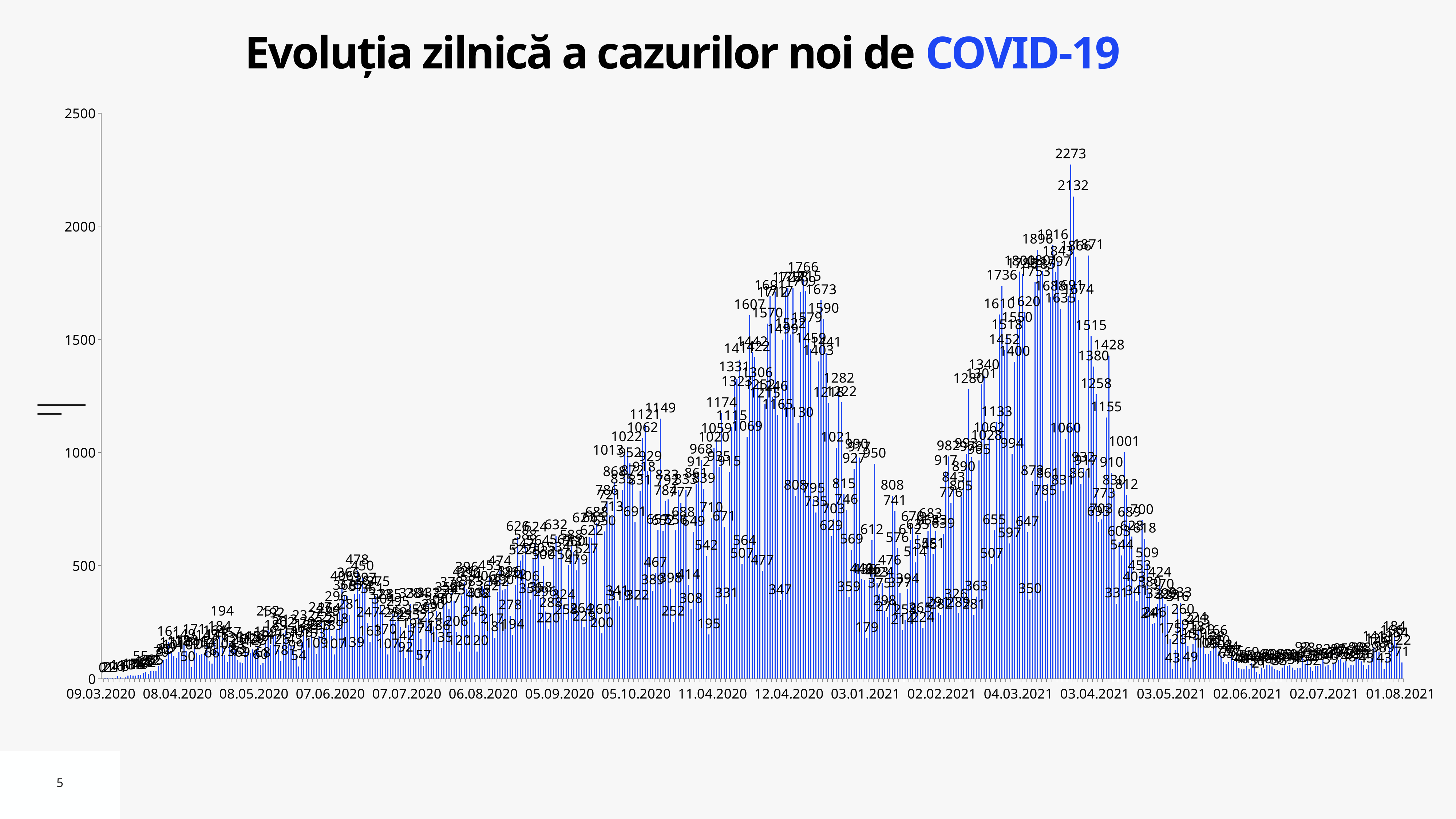
What is the last date shown on the x axis? 01.08.2021 What is the second-highest daily value labelled on the chart, just after the 2273 peak? 2132 Are the values around 02.06.2021 greater or less than 500? less Which peak is higher: the one near 03.04.2021 or the one near 12.04.2020? the one near 03.04.2021 What is the first date shown on the x axis? 09.03.2020 Is the highest value on the chart greater or less than 2000? greater Do the values rise or fall between 03.04.2021 and 02.06.2021? fall What is the title of the chart? Evoluția zilnică a cazurilor noi de COVID-19 What kind of chart is shown on the slide? bar chart What is the maximum value shown on the y axis? 2500 What is the highest value labelled in the peak near 12.04.2020? 1766 What is the highest daily value labelled on the chart? 2273